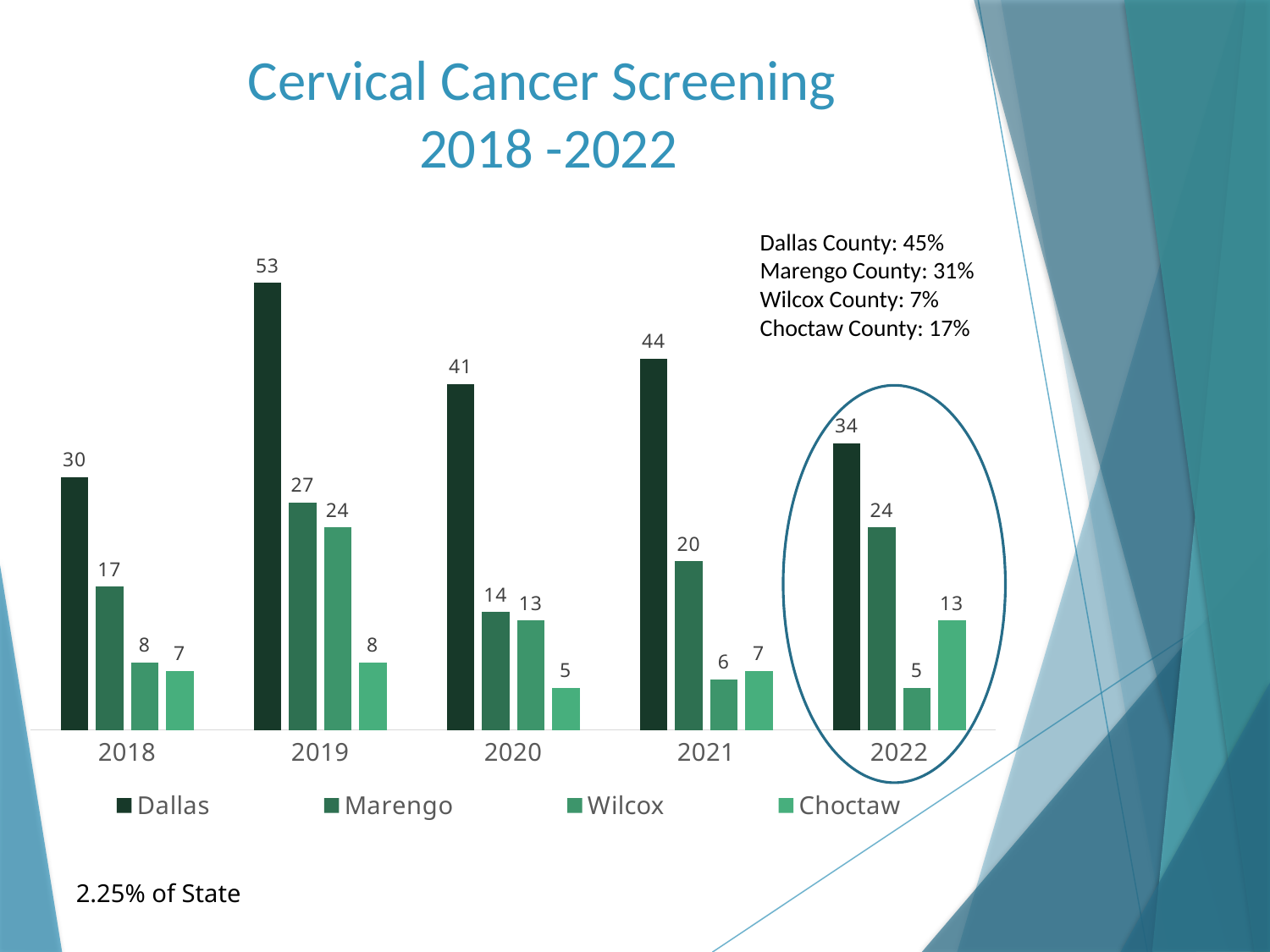
Does the Dallas value rise or fall from 2021 to 2022? Fall In which year is the Dallas value highest? 2019 What is the value for Choctaw in 2022? 13 What is the value for Dallas in 2019? 53 How many years are shown on the x axis? 5 In which year is the Marengo value lowest? 2020 Which is larger in 2020, the Marengo value or the Wilcox value? Marengo What is the title of the chart? Cervical Cancer Screening 2018 -2022 What is the difference between the Dallas and Marengo values in 2021? 24 What kind of chart is shown on the slide? Bar chart What is the value for Wilcox in 2020? 13 How many series does the legend list? 4